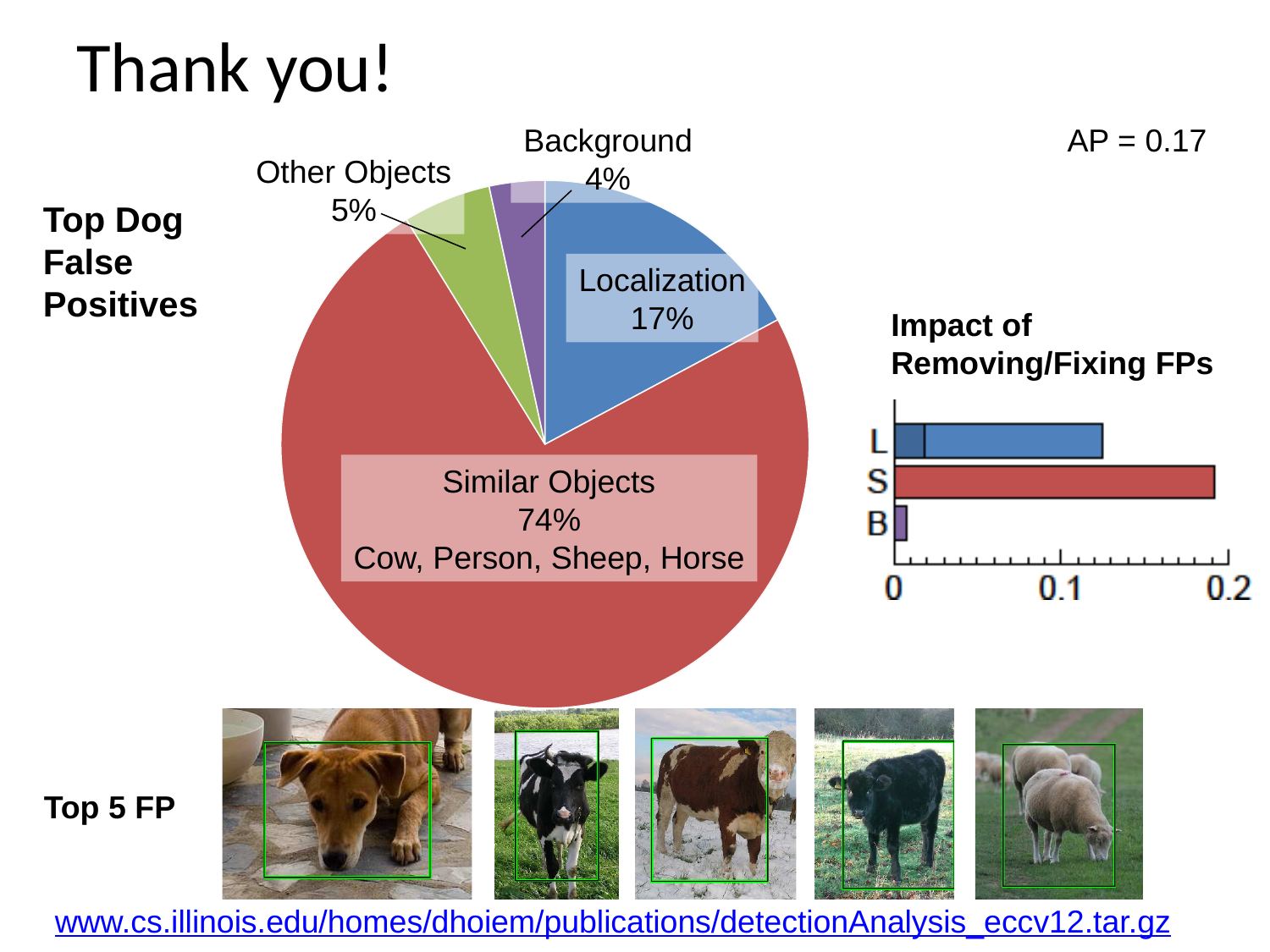
In the Top Dog False Positives pie chart, what is the difference in percentage points between Similar Objects and Localization? 57 In the Top Dog False Positives pie chart, how many slices are there? 4 What kind of chart is the Top Dog False Positives chart? pie chart What kind of chart is the Impact of Removing/Fixing FPs chart? bar chart In the Top Dog False Positives pie chart, what percentage is Other Objects? 5% In the Impact of Removing/Fixing FPs chart, is the value for L greater or less than 0.1? greater In the Top Dog False Positives pie chart, which slice is the largest? Similar Objects In the Impact of Removing/Fixing FPs chart, which bar is the longest? S In the Top Dog False Positives pie chart, what percentage is Localization? 17% In the Top Dog False Positives pie chart, which slice is the smallest? Background In the Top Dog False Positives pie chart, what percentage is Similar Objects? 74% In the Top Dog False Positives pie chart, what percentage is Background? 4%